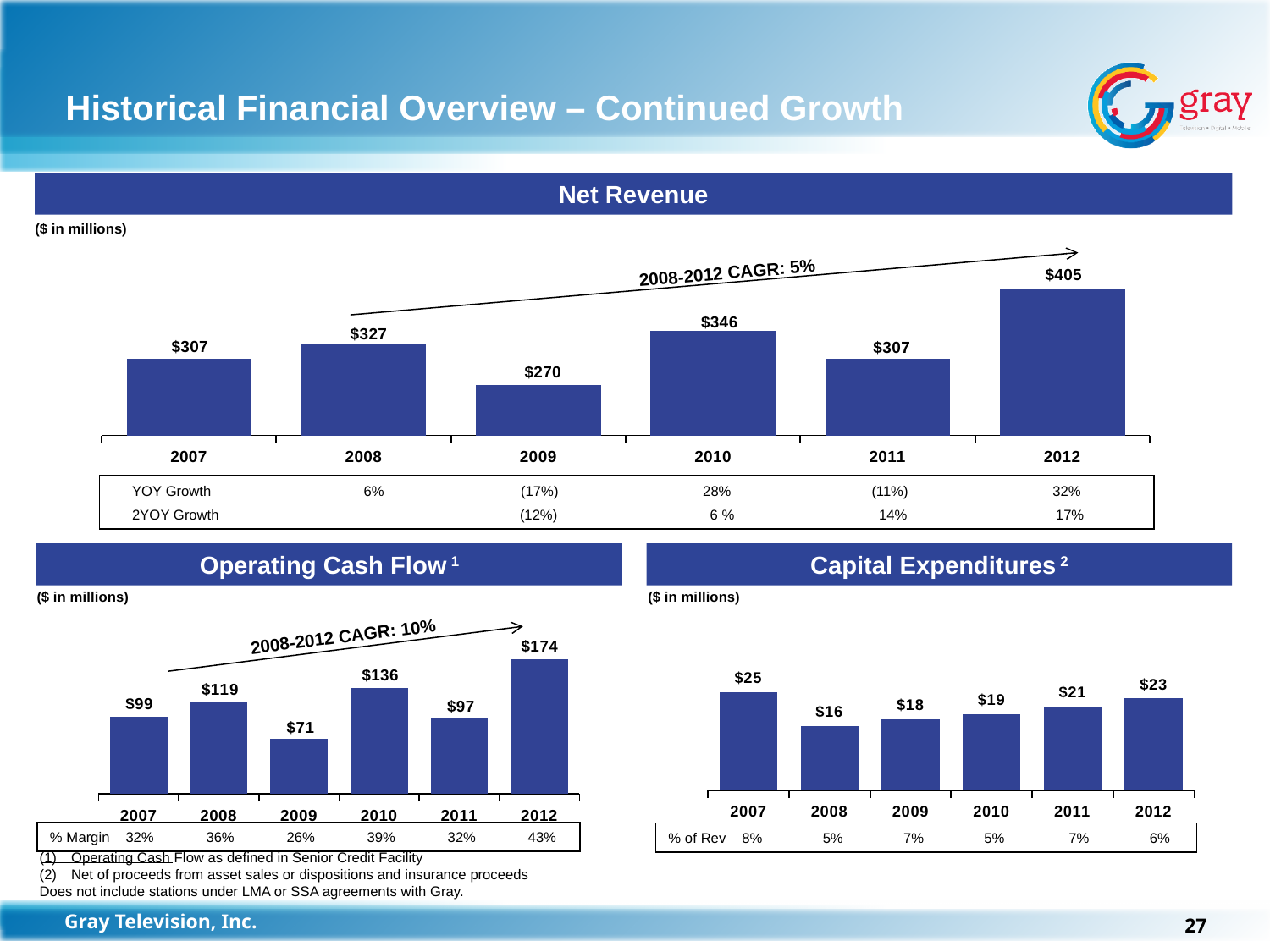
What kind of chart is the Capital Expenditures chart? Bar chart In the Net Revenue chart, what is the difference between the 2012 and 2011 values? $98 In the Net Revenue chart, which year has the lowest value? 2009 How many years are shown in the Net Revenue chart? 6 In the Operating Cash Flow chart, what is the value for 2009? $71 In the Operating Cash Flow chart, which is larger, the value for 2008 or the value for 2011? 2008 In the Capital Expenditures chart, what is the value for 2007? $25 In the Capital Expenditures chart, what is the difference between the 2012 and 2008 values? $7 In the Capital Expenditures chart, which year has the lowest value? 2008 In the Net Revenue chart, which year has the highest value? 2012 In the Net Revenue chart, what is the value for 2010? $346 In the Operating Cash Flow chart, which year has the highest value? 2012